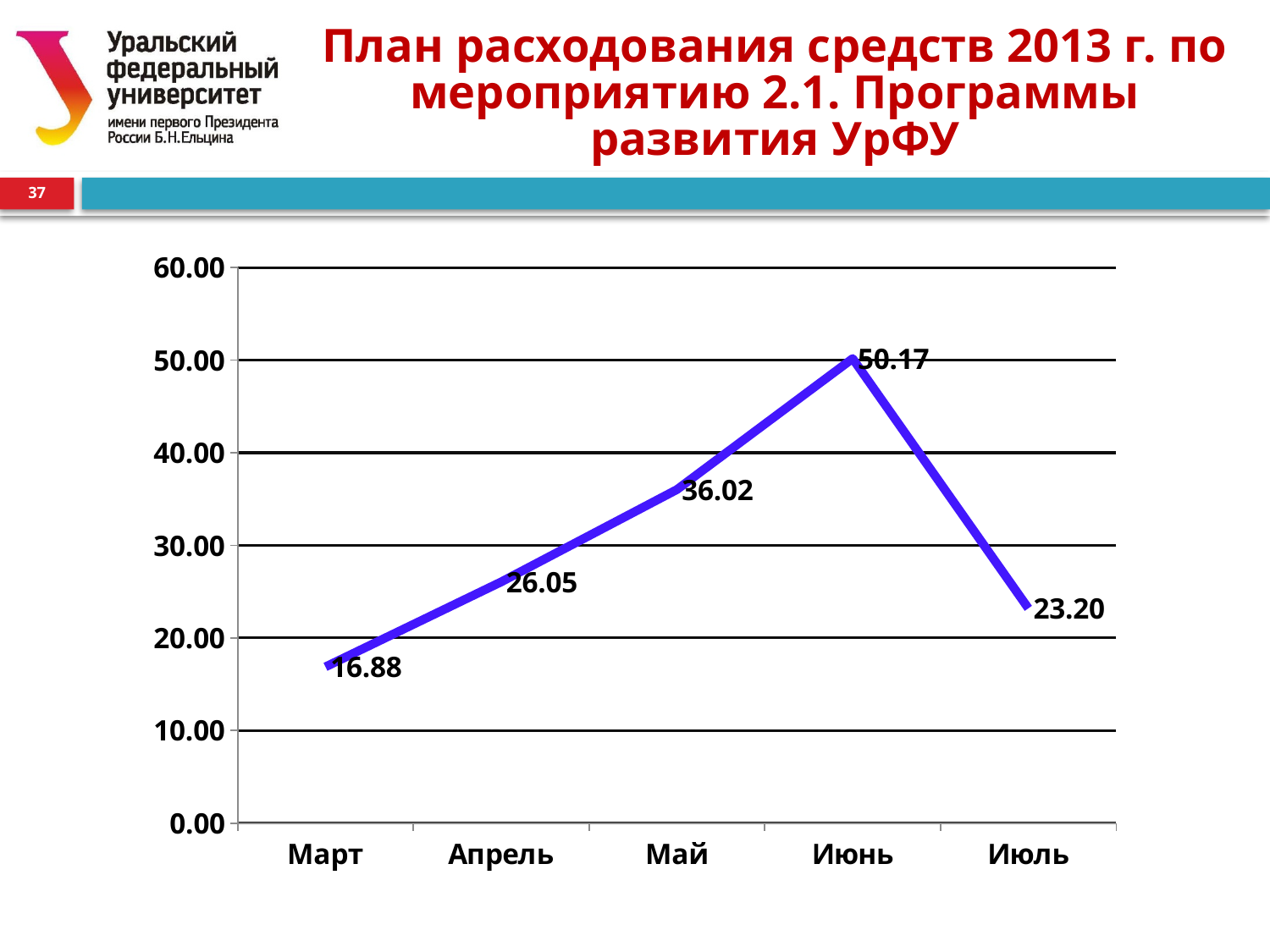
What is the value for Июль? 23.20 What kind of chart is shown on the slide? line chart How many months are plotted on the x axis? 5 Which month has the highest value? Июнь What is the value for Июнь? 50.17 Which month has the lowest value? Март What is the value for Март? 16.88 What is the difference between the values for Июнь and Май? 14.15 What is the difference between the values for Апрель and Март? 9.17 Is the value for Май greater or less than 40.00? less Which is larger, the value for Апрель or the value for Июль? Апрель Do the values rise or fall from Март to Июнь? rise